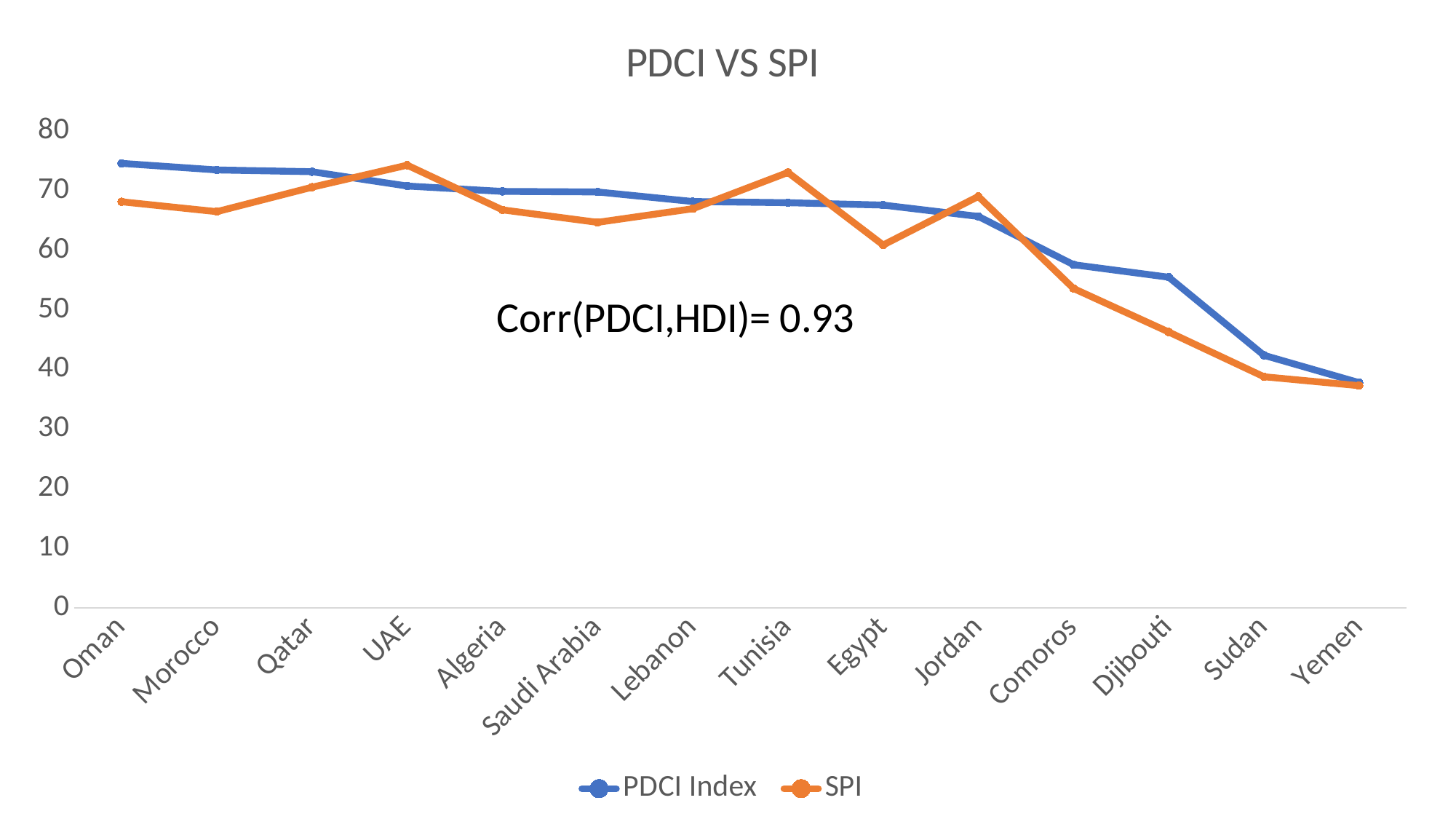
How many countries are plotted along the x axis? 14 Which country has the lowest PDCI Index value? Yemen How many series does the legend list? 2 Is the PDCI Index value for Oman greater or less than 70? greater For Egypt, which is larger: the PDCI Index or the SPI? PDCI Index What kind of chart is shown on the slide? Line chart Does the PDCI Index generally rise or fall from Oman to Yemen? Fall Is the SPI value for Djibouti greater or less than 50? less For Tunisia, which is larger: the PDCI Index or the SPI? SPI Which country has the highest PDCI Index value? Oman What is the title of the chart? PDCI VS SPI